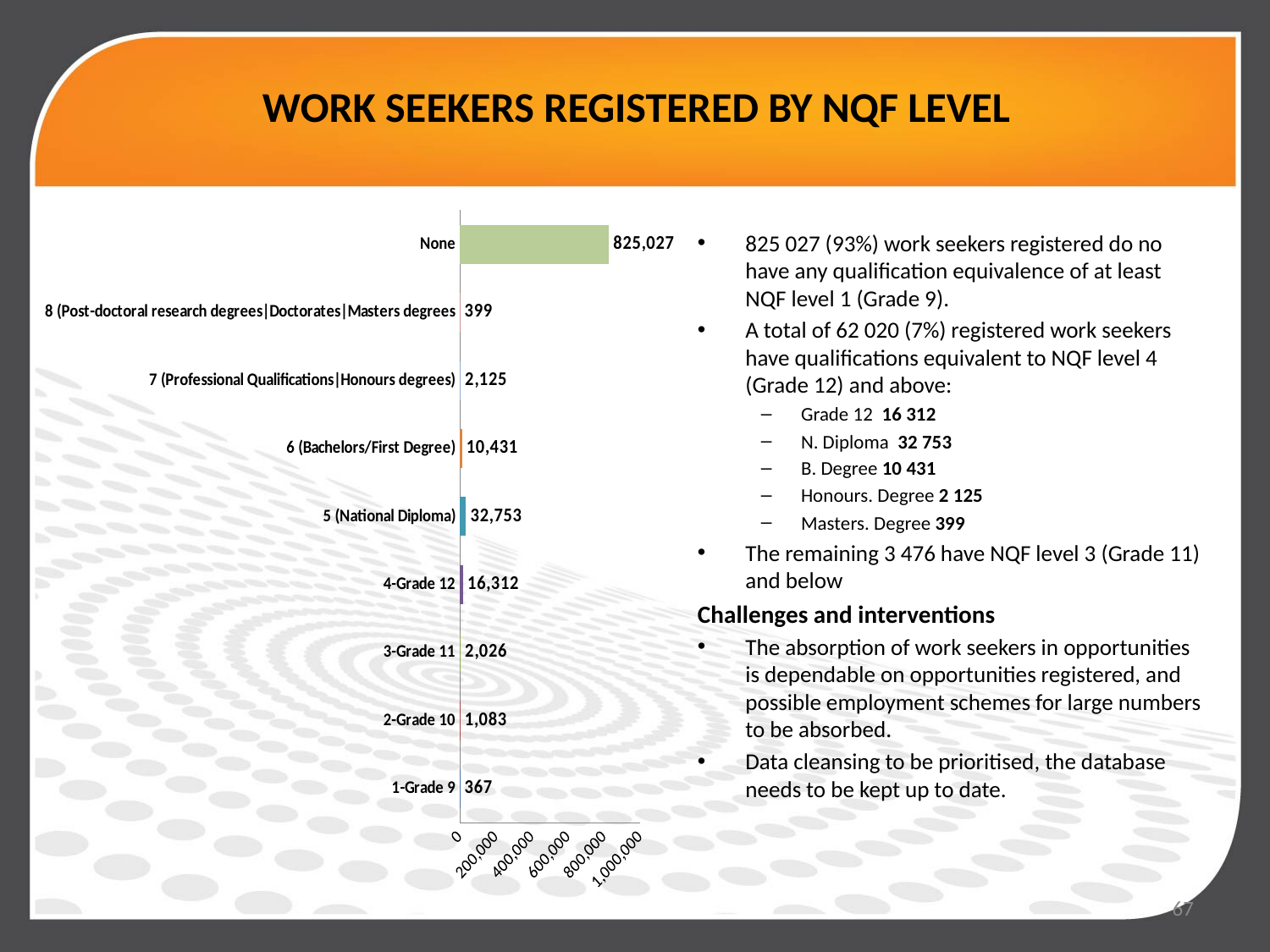
What is the difference between the values for 5 (National Diploma) and 4-Grade 12? 16,441 What kind of chart is shown on the slide? bar chart Is the value for None greater or less than 800,000? greater What is the value for 2-Grade 10? 1,083 What is the value for 4-Grade 12? 16,312 What is the value for 1-Grade 9? 367 Which category has the highest value? None How many categories are shown in the chart? 9 What is the value for the None category? 825,027 What is the value for 5 (National Diploma)? 32,753 Which category has the lowest value? 1-Grade 9 Which is larger, the value for 6 (Bachelors/First Degree) or the value for 7 (Professional Qualifications|Honours degrees)? 6 (Bachelors/First Degree)